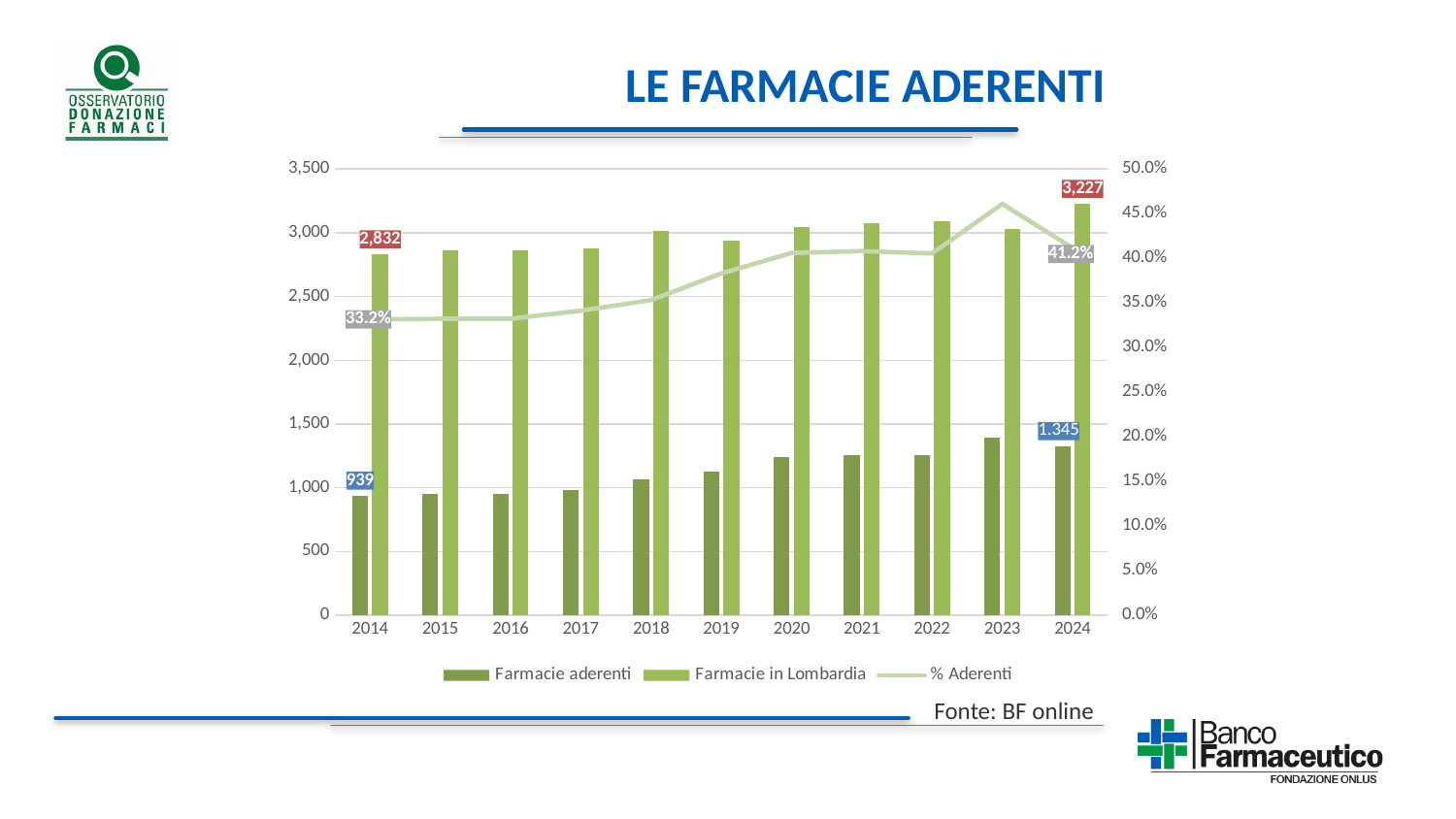
Does the Farmacie aderenti series generally rise or fall from 2014 to 2024? rise Is the value for Farmacie aderenti in 2023 greater or less than 1,000? greater What is the value for Farmacie aderenti in 2024? 1.345 What is the value for Farmacie in Lombardia in 2014? 2,832 How many years are shown on the x axis? 11 What is the % Aderenti value shown for 2014? 33.2% What is the value for Farmacie in Lombardia in 2024? 3,227 How many series does the legend list? 3 What is the value for Farmacie aderenti in 2014? 939 What is the % Aderenti value shown for 2024? 41.2% By how much did Farmacie in Lombardia increase from 2014 to 2024? 395 In which year is the Farmacie in Lombardia bar highest? 2024